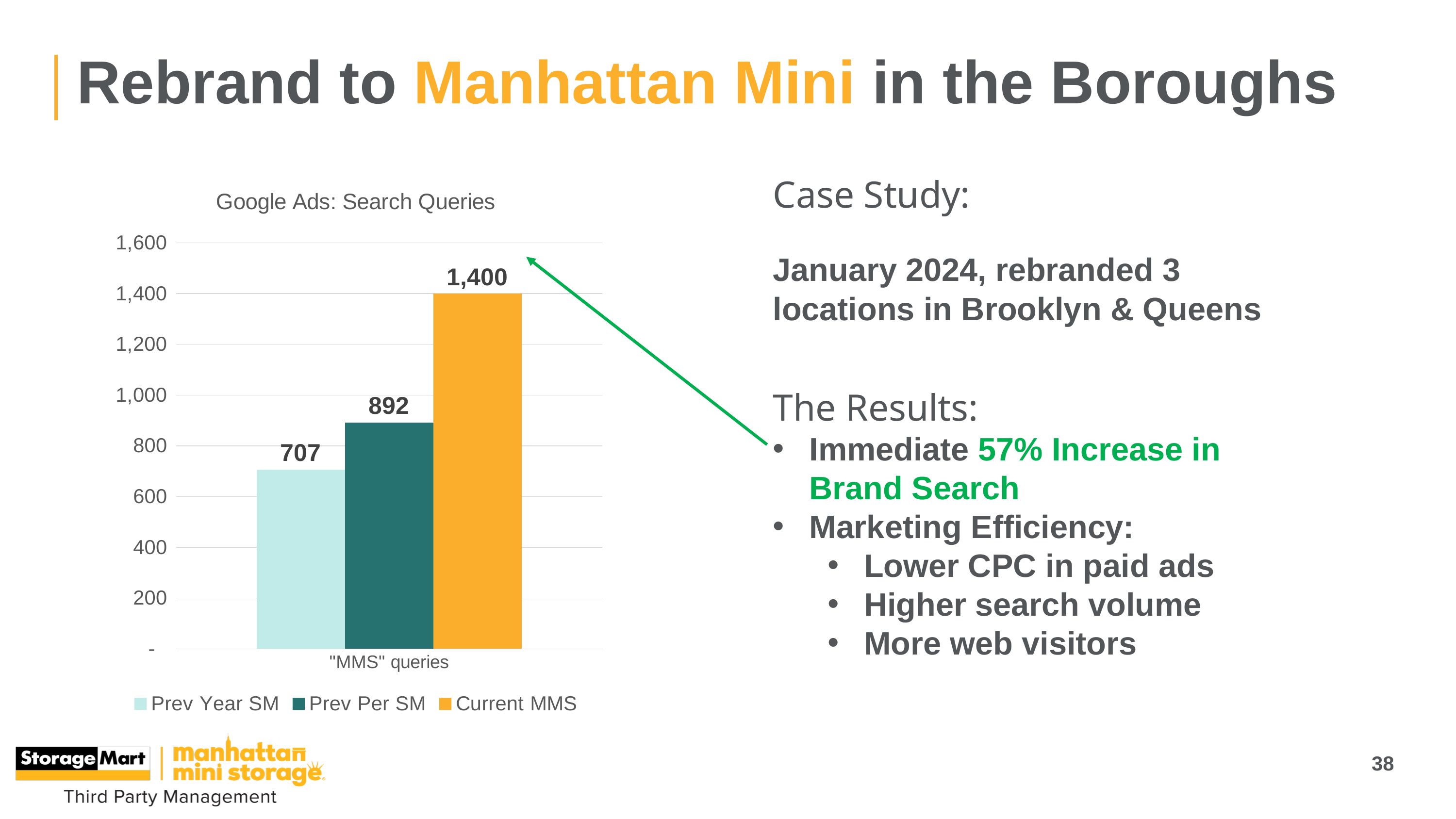
What is the value for Prev Year SM in the Google Ads: Search Queries chart? 707 What is the difference between the Prev Per SM and Prev Year SM values in the Google Ads: Search Queries chart? 185 What is the value for Current MMS in the Google Ads: Search Queries chart? 1,400 Which series has the lowest value in the Google Ads: Search Queries chart? Prev Year SM How many series does the legend list in the Google Ads: Search Queries chart? 3 What kind of chart is the Google Ads: Search Queries chart? bar chart What is the category label on the x axis of the Google Ads: Search Queries chart? "MMS" queries What is the value for Prev Per SM in the Google Ads: Search Queries chart? 892 Is the value for Prev Per SM greater or less than 1,000 in the Google Ads: Search Queries chart? less Which is larger in the Google Ads: Search Queries chart, Prev Year SM or Prev Per SM? Prev Per SM Which series has the highest value in the Google Ads: Search Queries chart? Current MMS What is the difference between the Current MMS and Prev Per SM values in the Google Ads: Search Queries chart? 508